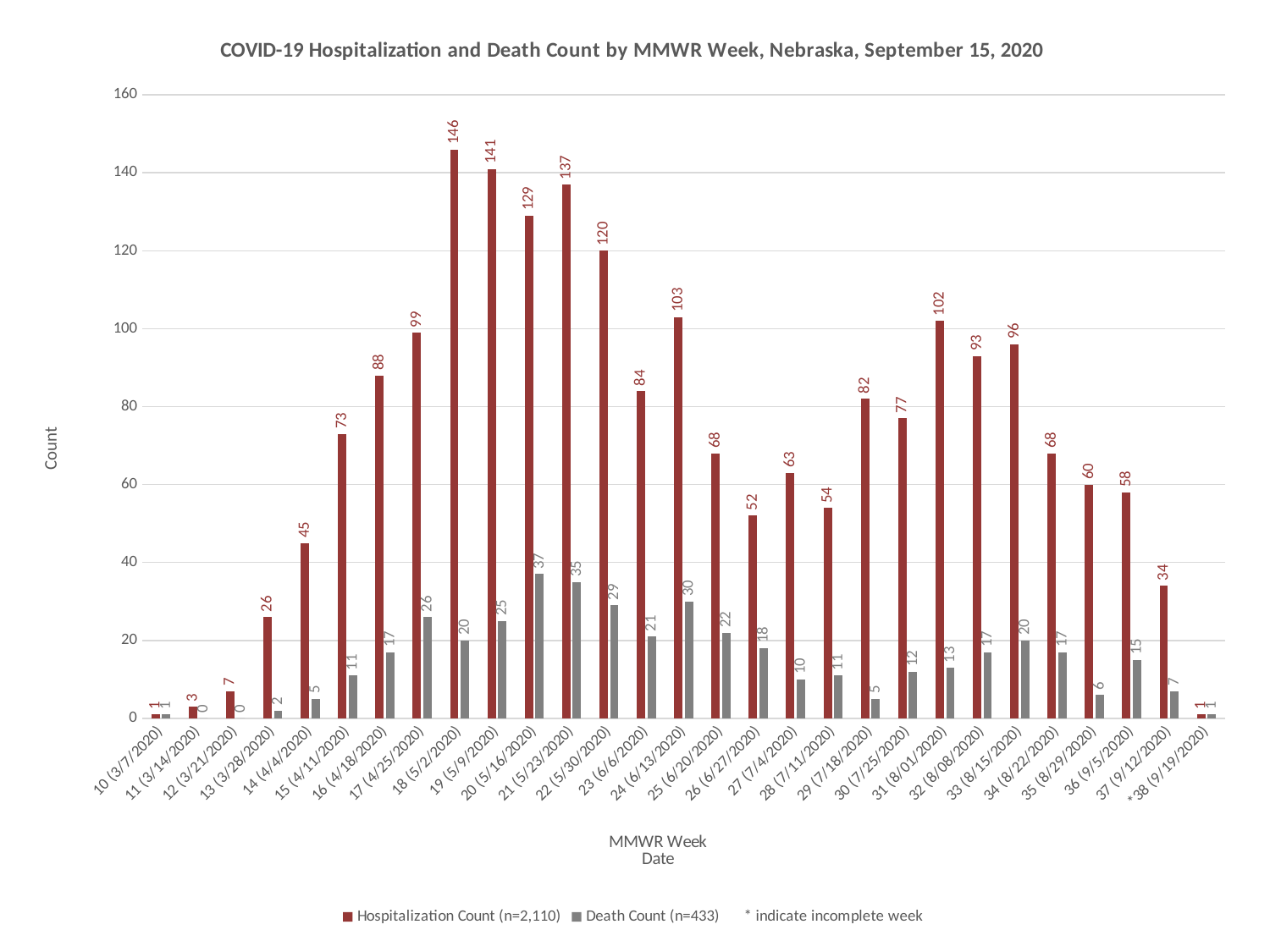
What is the difference between the hospitalization count and the death count for MMWR week 21 (5/23/2020)? 102 Which MMWR week has the highest death count? 20 (5/16/2020) How many series does the legend list? 2 What is the hospitalization count for MMWR week 18 (5/2/2020)? 146 Do the hospitalization counts rise or fall from MMWR week 10 (3/7/2020) to week 18 (5/2/2020)? Rise Which MMWR week has the highest hospitalization count? 18 (5/2/2020) What kind of chart is shown on the slide? Bar chart How many MMWR weeks are shown on the x axis? 29 Is the hospitalization count for MMWR week 24 (6/13/2020) greater or less than 100? greater What is the death count for MMWR week 20 (5/16/2020)? 37 What total number of deaths (n) is given in the legend for the Death Count series? 433